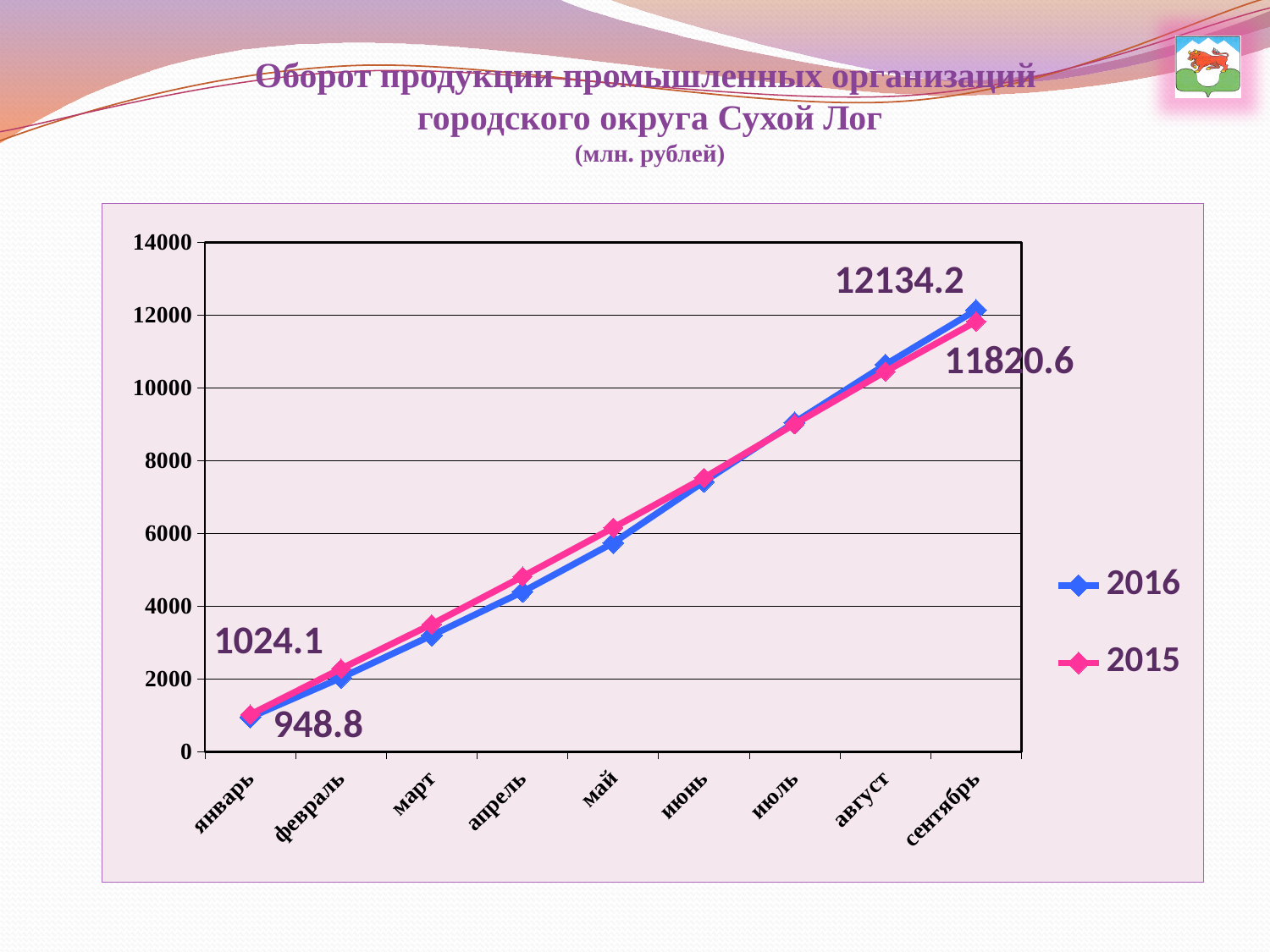
How many series does the legend list? 2 In январь, which series has the larger value, 2016 or 2015? 2015 How many months are shown on the x axis? 9 What is the difference between the 2016 and 2015 values in сентябрь? 313.6 What is the value for 2015 in январь? 1024.1 What is the difference between the 2015 and 2016 values in январь? 75.3 What is the value for 2016 in сентябрь? 12134.2 Is the value for 2016 in август greater or less than 10000? greater In сентябрь, which series has the larger value, 2016 or 2015? 2016 What is the value for 2016 in январь? 948.8 What is the value for 2015 in сентябрь? 11820.6 What kind of chart is shown on the slide? line chart